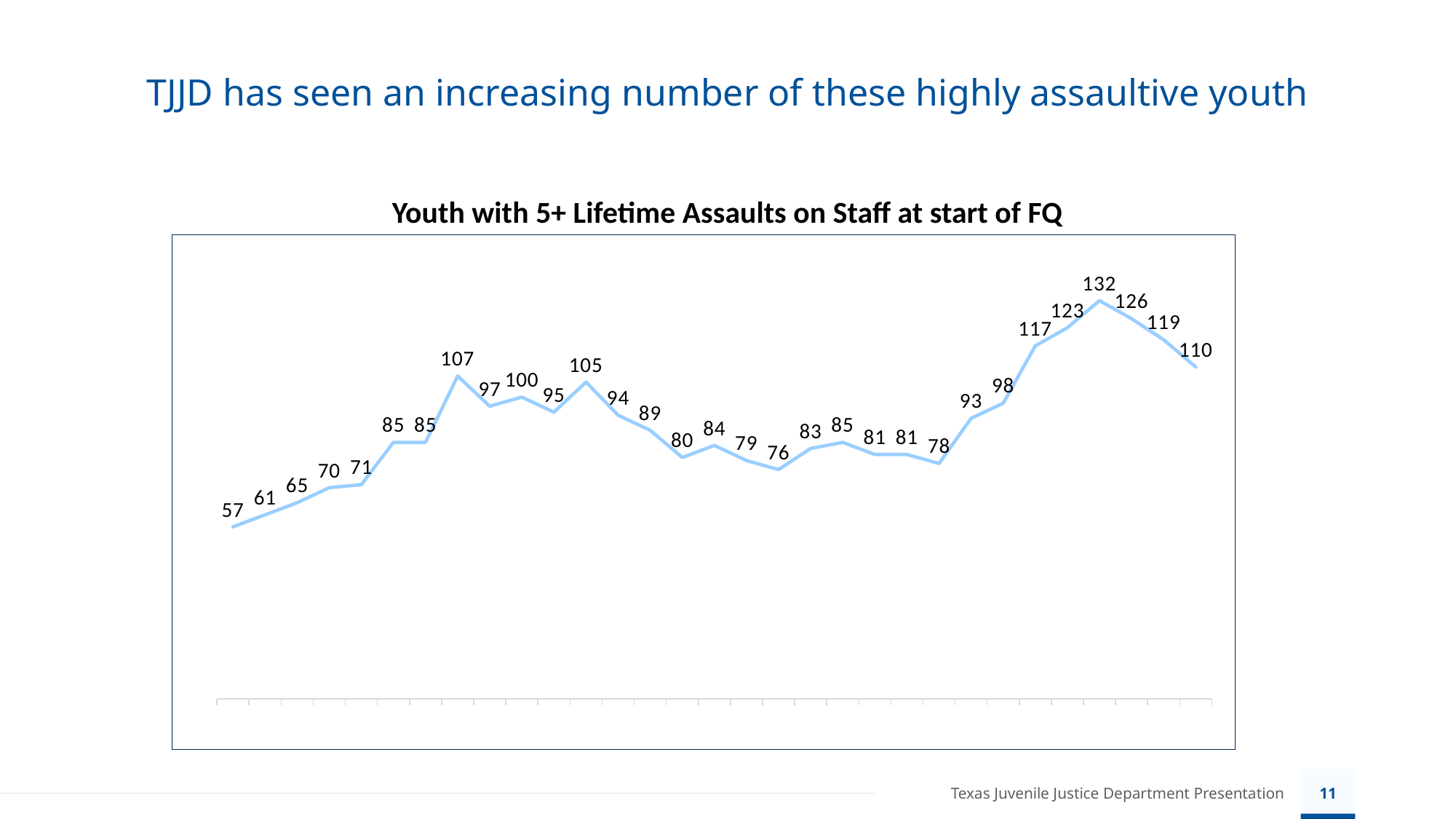
How many data points are plotted on the line? 31 What is the highest value plotted on the line? 132 What is the difference between the peak value of 132 and the final value of 110? 22 What kind of chart is shown on the slide? line chart What is the value of the last data point on the line? 110 What is the value of the first data point on the line? 57 What is the lowest value plotted on the line? 57 What is the title of the chart? Youth with 5+ Lifetime Assaults on Staff at start of FQ Which is larger, the first data point or the last data point on the line? the last data point (110) What is the difference between the highest value (132) and the first value (57)? 75 What is the value of the data point immediately after the peak of 132? 126 Overall, do the values rise or fall from the start of the line to the end? rise